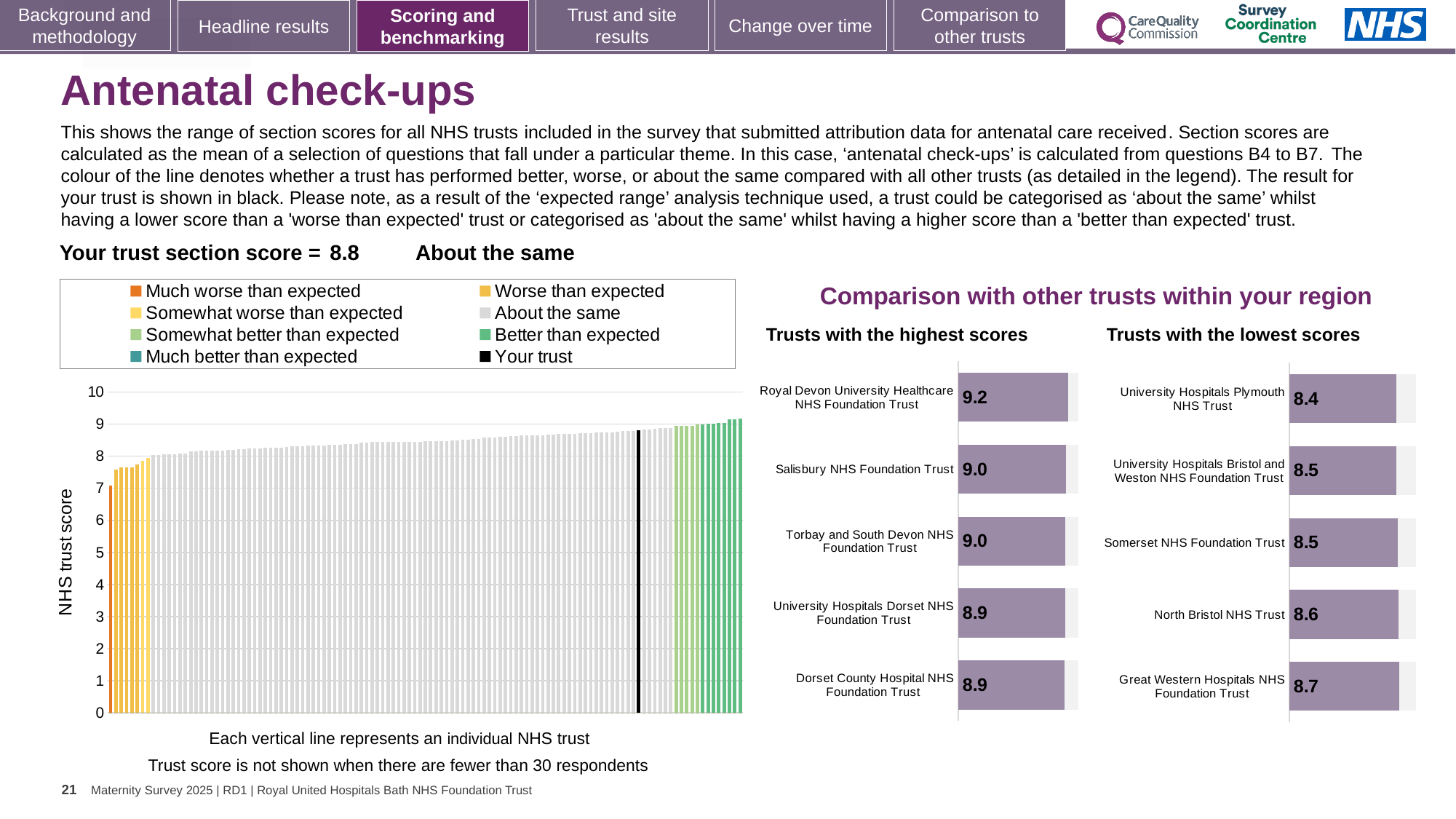
In the NHS trust score chart on the left, how many entries does the legend list? 8 In the 'Trusts with the lowest scores' chart, what is the score for Great Western Hospitals NHS Foundation Trust? 8.7 In the NHS trust score chart on the left, do the trust scores rise or fall from left to right? Rise In the 'Trusts with the lowest scores' chart, which trust has the lowest score? University Hospitals Plymouth NHS Trust In the 'Trusts with the lowest scores' chart, which has the larger score: North Bristol NHS Trust or University Hospitals Plymouth NHS Trust? North Bristol NHS Trust What kind of chart is the 'Trusts with the lowest scores' chart? Bar chart In the NHS trust score chart on the left, is the value of the black 'Your trust' bar greater or less than 8? greater In the 'Trusts with the lowest scores' chart, what is the score for Somerset NHS Foundation Trust? 8.5 In the 'Trusts with the highest scores' chart, how many trusts are shown? 5 In the 'Trusts with the highest scores' chart, what is the score for Royal Devon University Healthcare NHS Foundation Trust? 9.2 In the 'Trusts with the highest scores' chart, which trust has the highest score? Royal Devon University Healthcare NHS Foundation Trust In the 'Trusts with the highest scores' chart, what is the difference between the scores of Royal Devon University Healthcare NHS Foundation Trust and Dorset County Hospital NHS Foundation Trust? 0.3